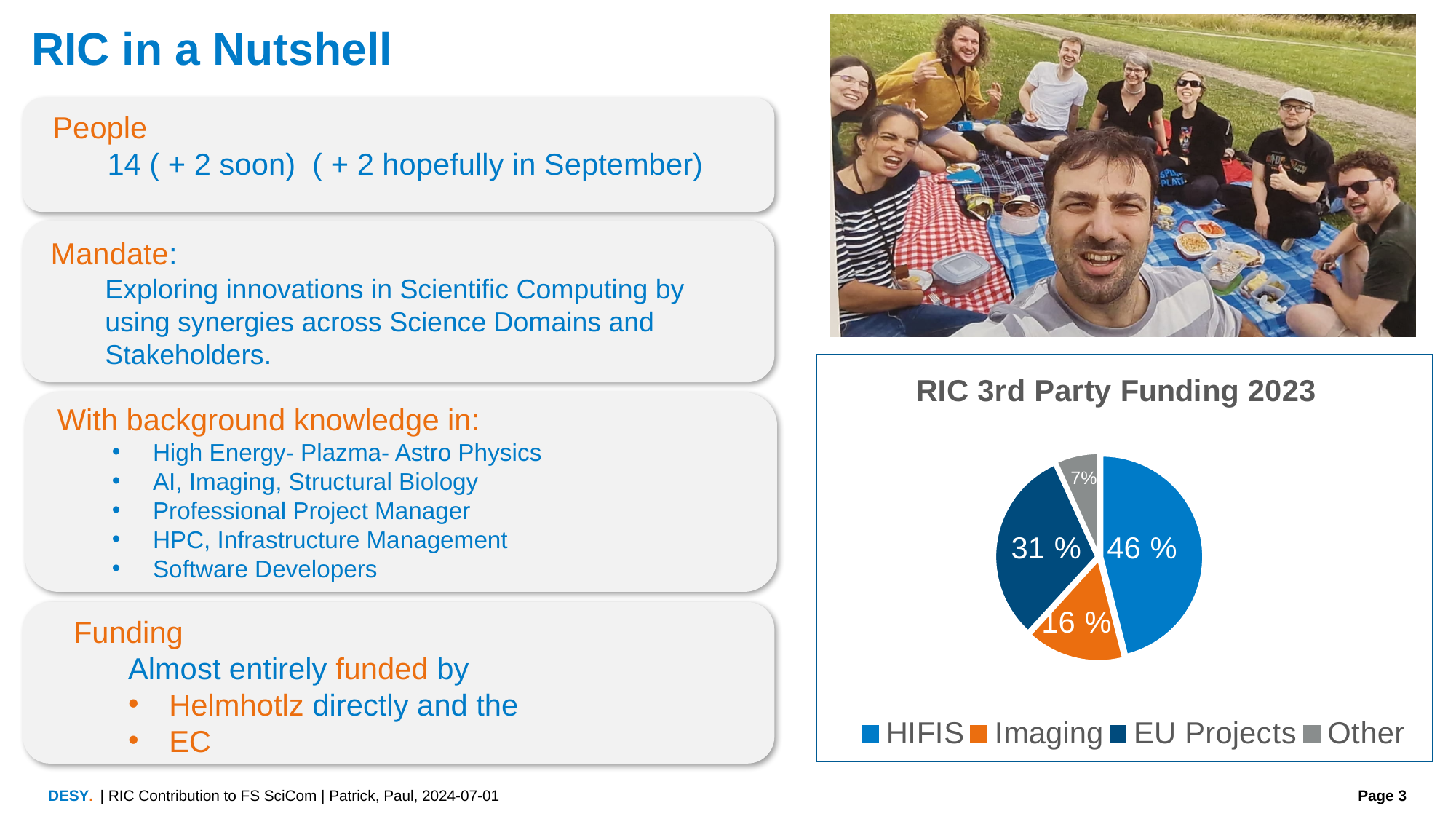
Which category has the smallest slice of the pie? Other What share of the pie do EU Projects have? 31 % Which is larger, the share for EU Projects or the share for Imaging? EU Projects What is the difference in percentage points between the HIFIS share and the EU Projects share? 15 What share of the pie does Imaging have? 16 % How many categories does the legend list? 4 Which category has the largest slice of the pie? HIFIS What colour is the Imaging slice in the pie chart? orange What share of the pie does Other have? 7% What kind of chart is shown on the slide? pie chart What is the title of the chart? RIC 3rd Party Funding 2023 What share of the pie does HIFIS have? 46 %